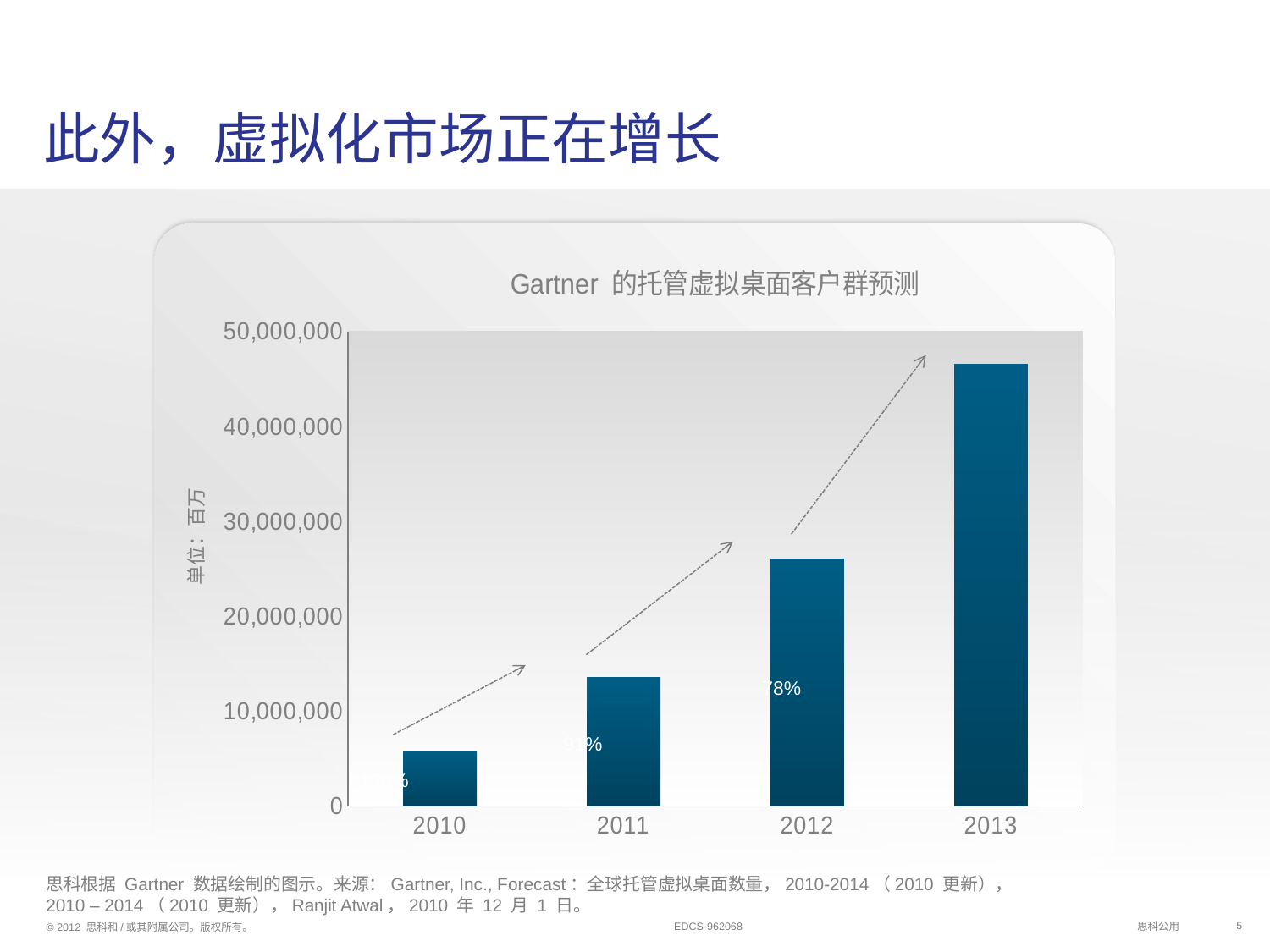
Which year has the lowest bar in the chart? 2010 Which year has the highest bar in the chart? 2013 Is the value for 2013 greater or less than 40,000,000? greater What kind of chart is shown on the slide? bar chart Is the value for 2010 greater or less than 10,000,000? less Is the value for 2011 greater or less than 10,000,000? greater How many years are shown on the x axis of the chart? 4 Which is larger, the value for 2011 or the value for 2012? 2012 Do the values rise or fall from 2010 to 2013? rise What percentage label is printed on the 2012 bar? 78% What is the title of the chart? Gartner 的托管虚拟桌面客户群预测